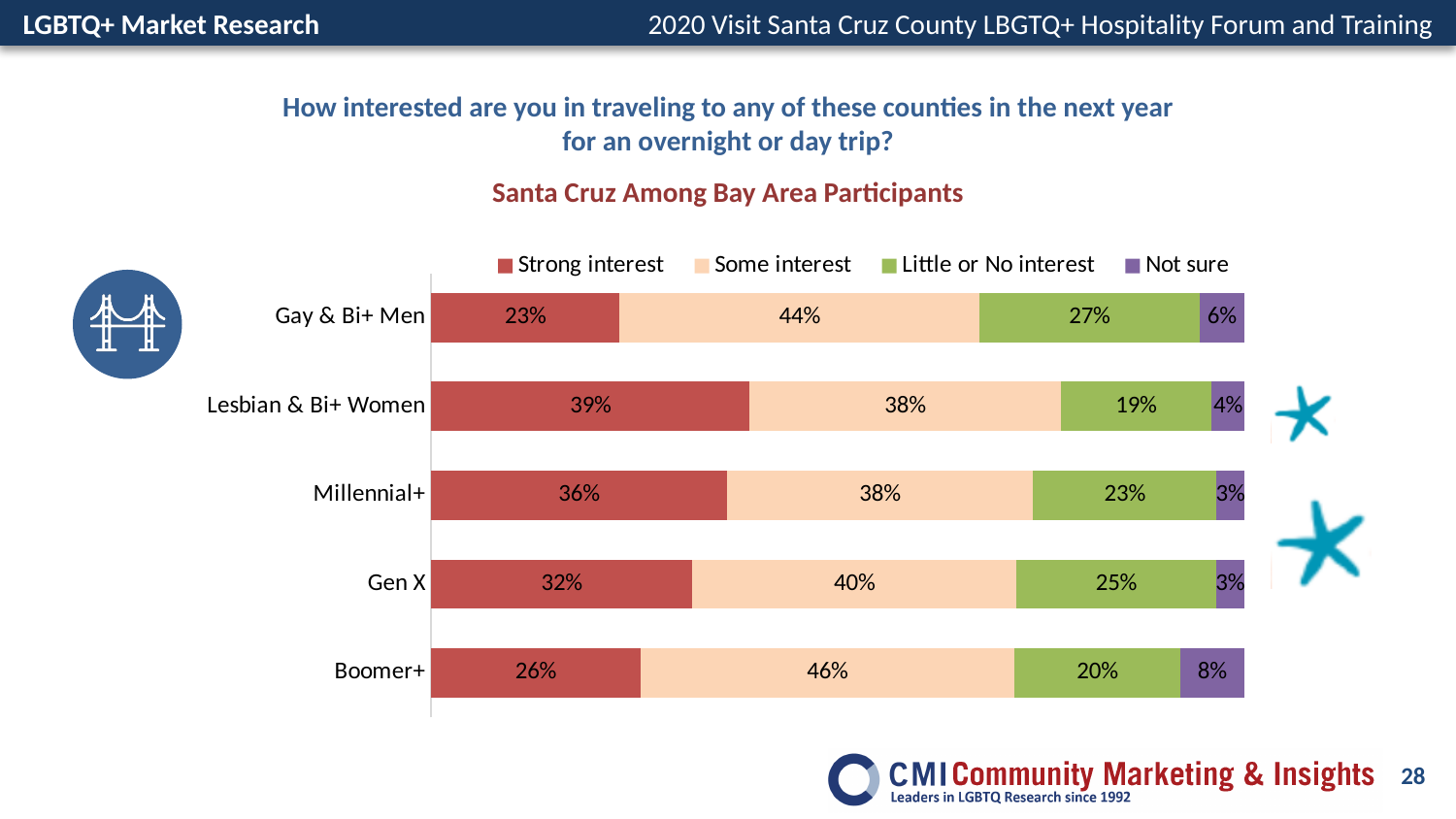
What percentage of Lesbian & Bi+ Women reported Strong interest? 39% How many series does the legend list? 4 What is the difference between the Some interest values for Boomer+ and Millennial+? 8% What percentage of Gay & Bi+ Men reported Some interest? 44% What is the combined Strong interest and Some interest value for Gen X? 72% Which category has the lowest Strong interest value? Gay & Bi+ Men Which category has the highest Strong interest value? Lesbian & Bi+ Women Which is larger: the Little or No interest value for Gay & Bi+ Men or for Lesbian & Bi+ Women? Gay & Bi+ Men How many categories are shown on the chart? 5 What percentage of Gen X reported Little or No interest? 25% What percentage of Boomer+ respondents were Not sure? 8% What kind of chart is shown on the slide? Stacked bar chart